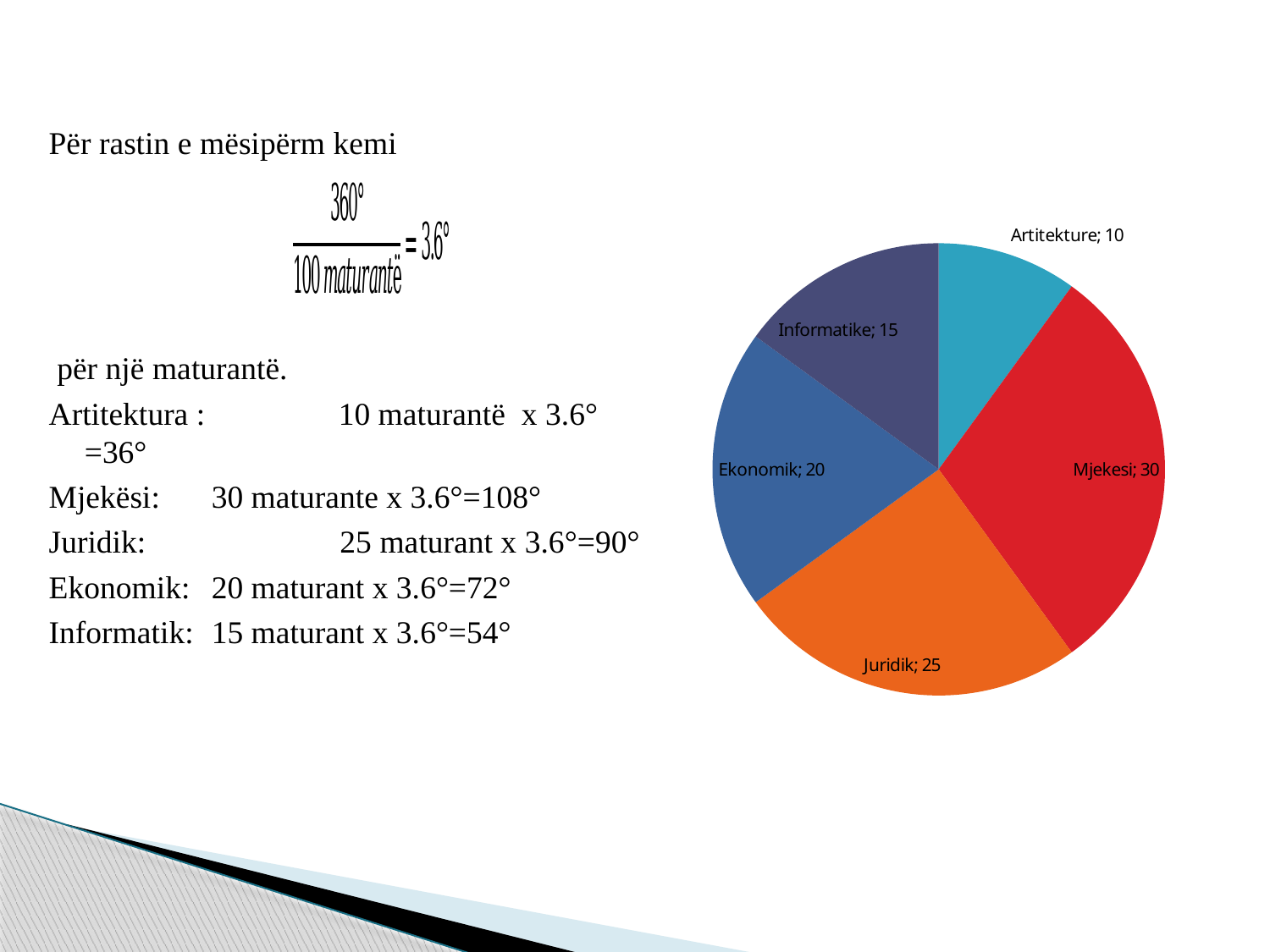
Which category has the largest slice in the pie chart? Mjekesi Which category has the smallest slice in the pie chart? Artitekture What share of the pie does Mjekesi represent? 30% What is the value for Informatike in the pie chart? 15 How many slices does the pie chart have? 5 Which is larger, the value for Juridik or the value for Ekonomik? Juridik What is the value for Artitekture in the pie chart? 10 What type of chart is shown on the slide? pie chart What is the value for Mjekesi in the pie chart? 30 What colour is the Juridik slice in the pie chart? orange What share of the pie does Juridik represent? 25% What is the difference between the values for Mjekesi and Ekonomik? 10